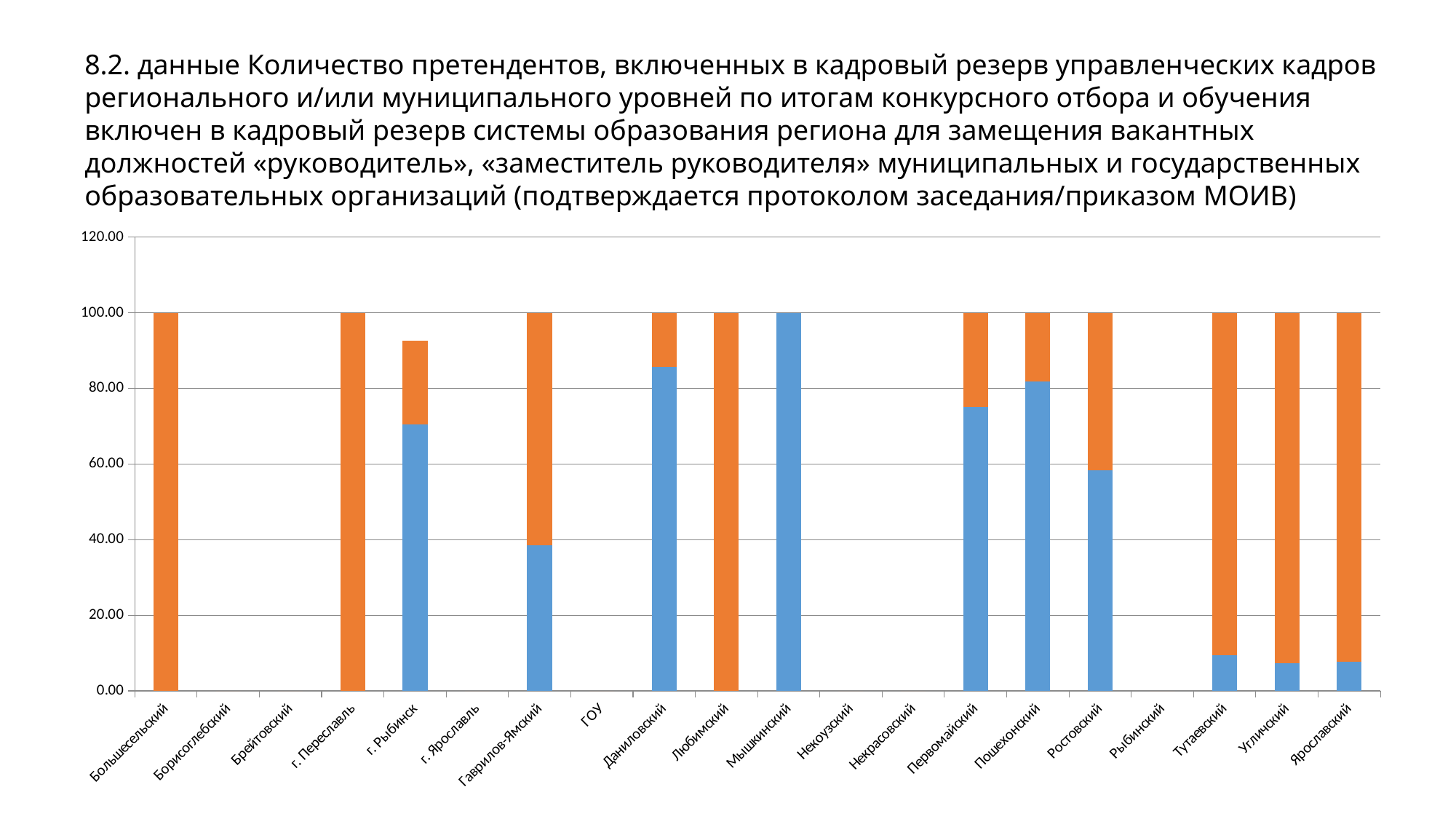
Is the blue portion of the bar for Гаврилов-Ямский greater or less than 40? less What kind of chart is shown on the slide? Stacked bar chart Is the blue portion of the bar for Тутаевский greater or less than 20? less Which category's bar is entirely blue with no orange portion? Мышкинский How many categories on the x axis have no bar at all? 7 What is the total height of the bar for Мышкинский? 100.00 How many categories are listed along the x axis? 20 Is the total height of the bar for г. Рыбинск greater or less than 100? less What is the total height of the bar for Большесельский? 100.00 Which has the larger blue portion, Даниловский or Гаврилов-Ямский? Даниловский